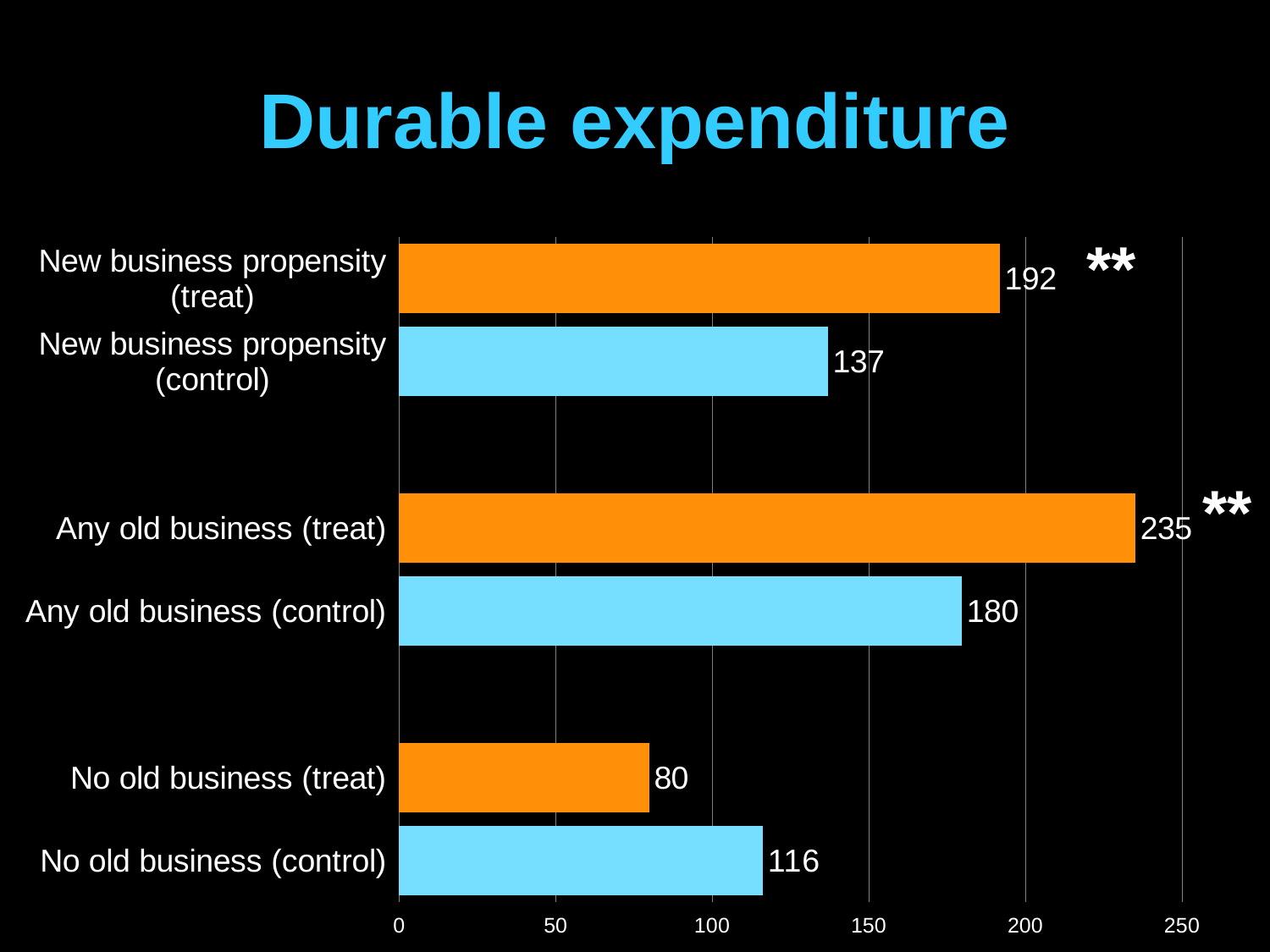
Which category has the highest value? Any old business (treat) What is the value for New business propensity (control)? 137 What is the value for Any old business (treat)? 235 Is the value for Any old business (control) greater or less than 150? greater Which category has the lowest value? No old business (treat) Which is larger, No old business (treat) or No old business (control)? No old business (control) What kind of chart is shown on the slide? bar chart How many bars are shown in the chart? 6 What is the difference between Any old business (treat) and Any old business (control)? 55 What is the title of the chart? Durable expenditure What is the value for No old business (treat)? 80 What is the difference between New business propensity (treat) and New business propensity (control)? 55